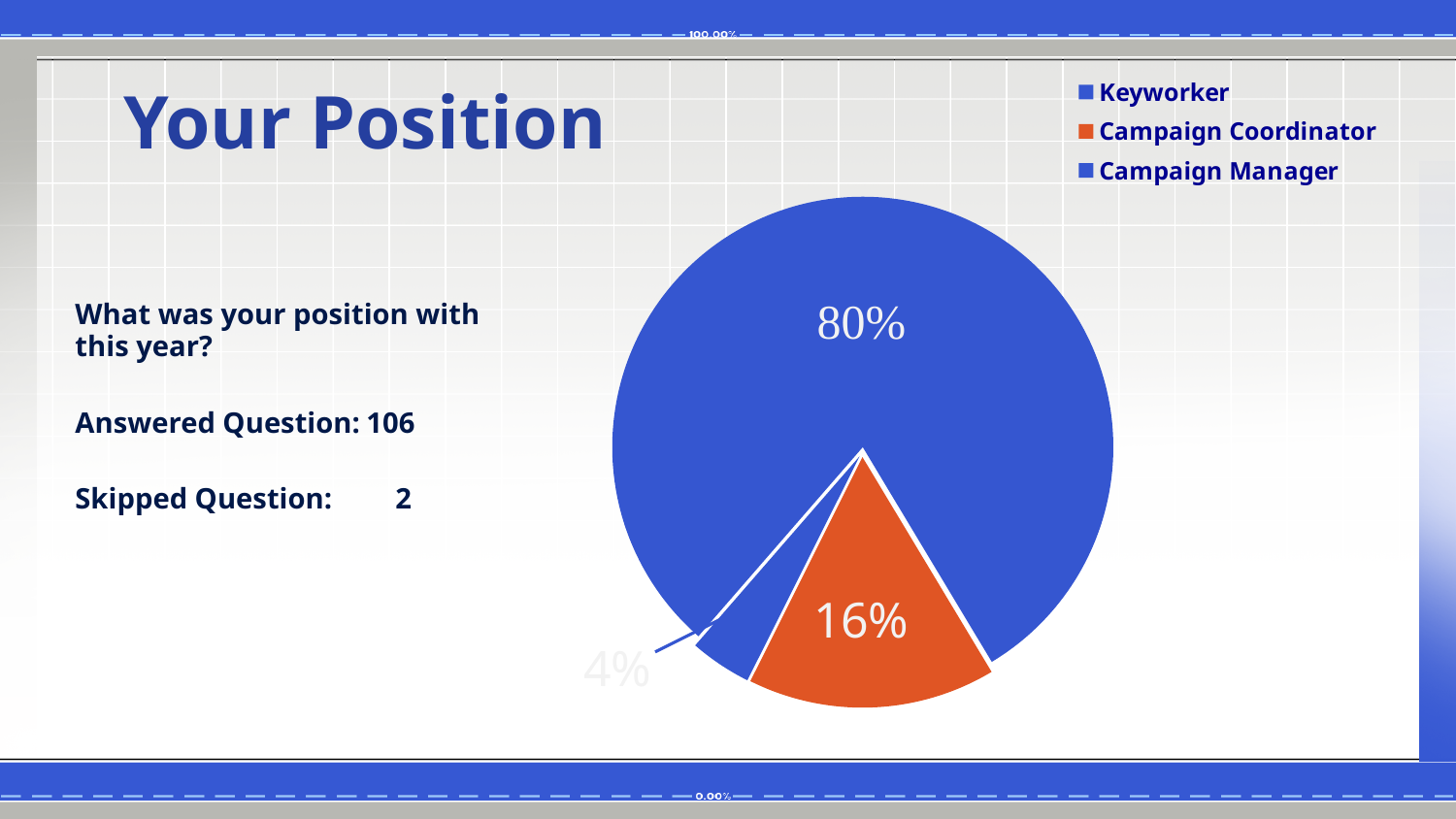
What is the title of the slide containing the pie chart? Your Position Which position has the largest slice of the pie? Keyworker What kind of chart is shown on the slide? pie chart What is the difference in percentage points between the Keyworker slice and the Campaign Coordinator slice? 64 How many entries does the legend list? 3 Which position has the smallest slice of the pie? Campaign Manager How many slices does the pie chart have? 3 Which slice is larger, Campaign Coordinator or Campaign Manager? Campaign Coordinator What percentage of the pie is Campaign Coordinator? 16% What colour is the Campaign Coordinator slice? orange What percentage of the pie is Keyworker? 80% What percentage of the pie is Campaign Manager? 4%